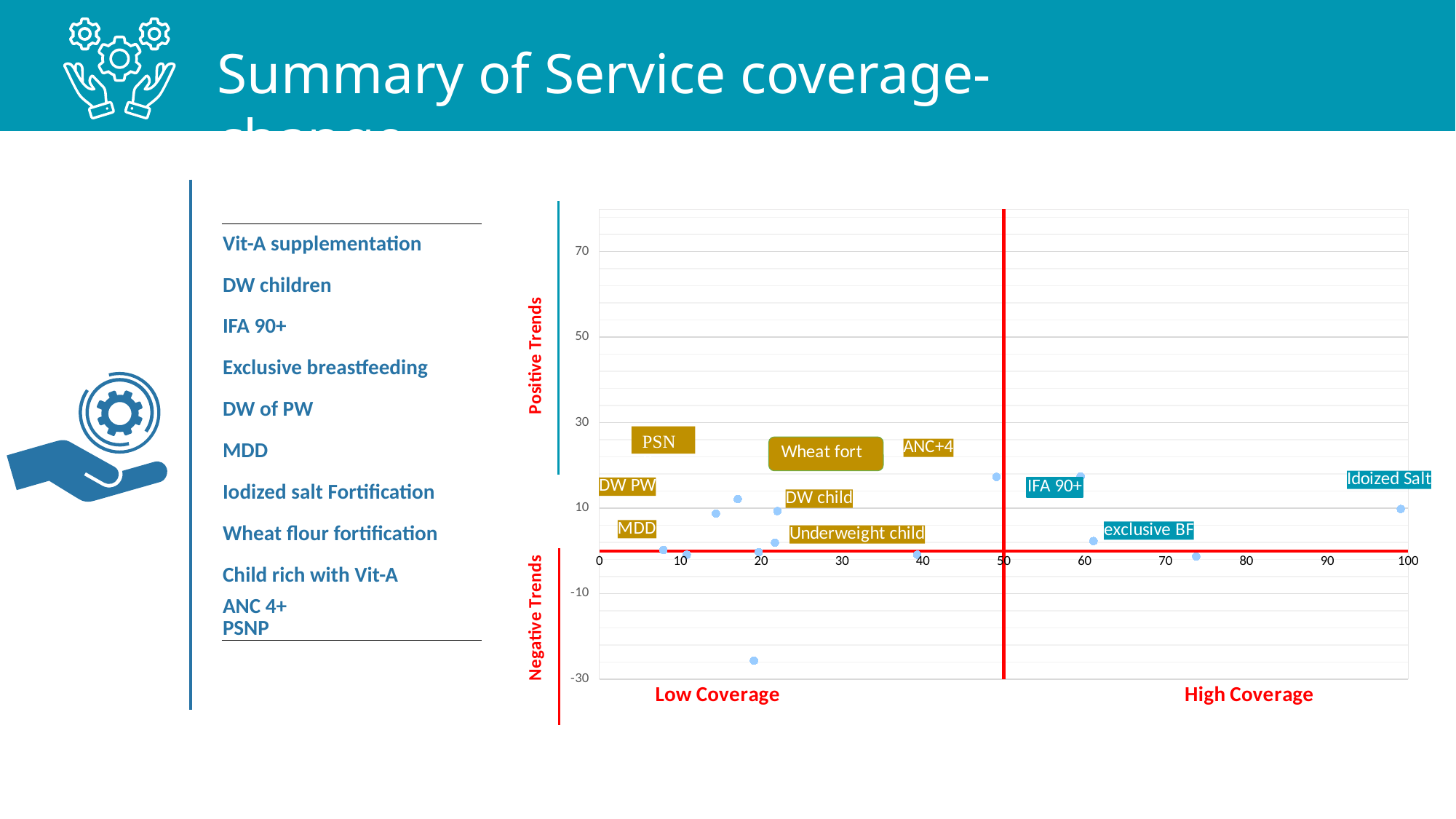
What is the highest tick value shown on the horizontal axis of the chart? 100 Is the horizontal (coverage) value for the point labelled exclusive BF greater or less than 50? greater At what horizontal-axis value is the vertical red line dividing Low Coverage from High Coverage drawn? 50 What kind of chart is shown on the slide? scatter chart Is the vertical (trend) value for the point labelled Idoized Salt greater or less than 30? less Is the horizontal (coverage) value for the point labelled IFA 90+ greater or less than 50? greater